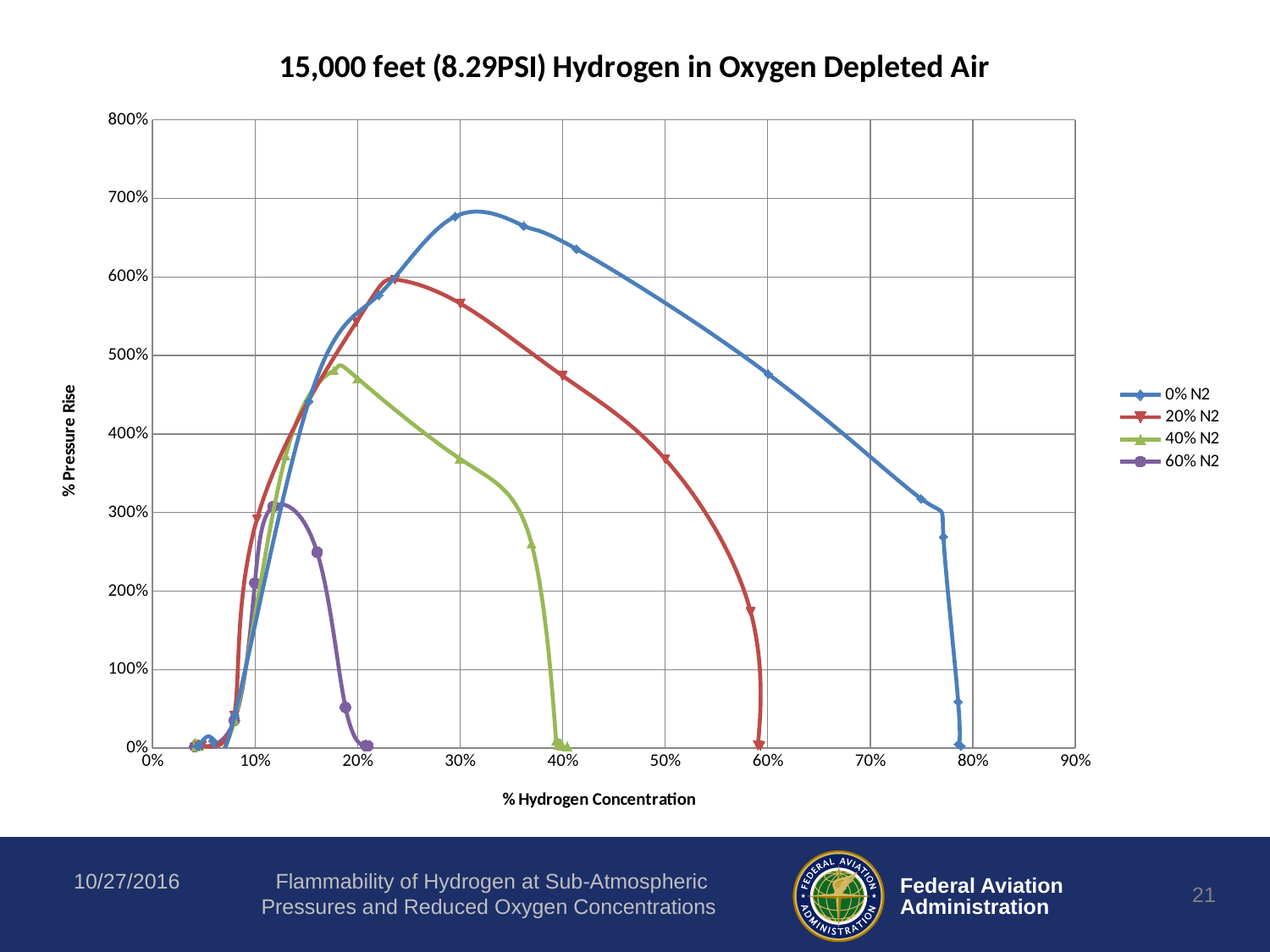
Is the peak value of the 0% N2 series greater or less than 600%? greater Which series has a higher peak pressure rise, 20% N2 or 40% N2? 20% N2 What kind of chart is shown on the slide? line chart How many series does the legend list? 4 Which series extends to the highest hydrogen concentration before returning to 0% pressure rise? 0% N2 Which series reaches the highest peak pressure rise? 0% N2 What is the label of the x axis? % Hydrogen Concentration Is the peak value of the 60% N2 series greater or less than 400%? less What is the title of the chart? 15,000 feet (8.29PSI) Hydrogen in Oxygen Depleted Air For the 0% N2 series, does the pressure rise increase or decrease as hydrogen concentration goes from 30% to 70%? decrease Is the peak value of the 40% N2 series greater or less than 500%? less Which series has the lowest peak pressure rise? 60% N2